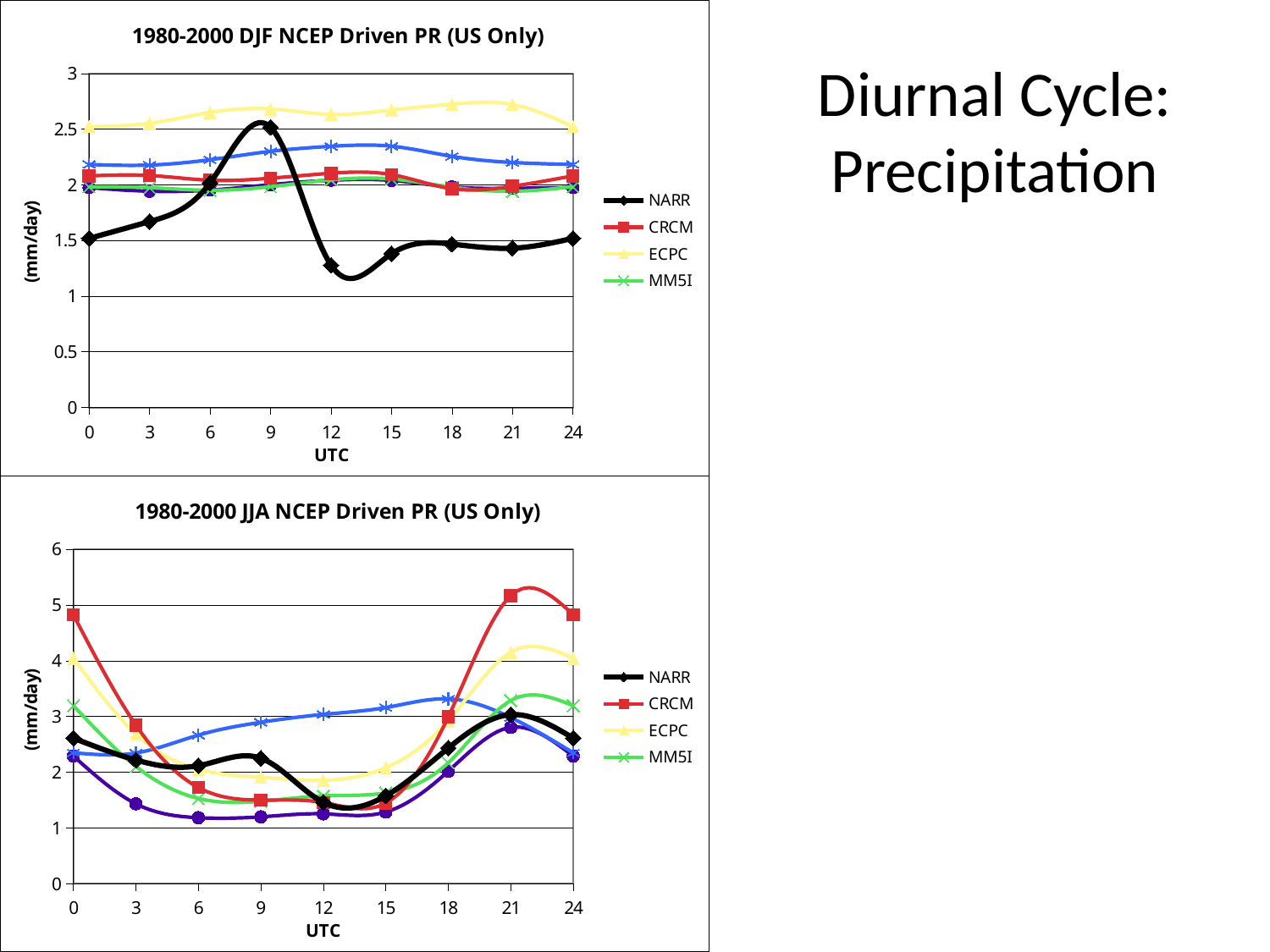
In the bottom chart, '1980-2000 JJA NCEP Driven PR (US Only)', is the CRCM value at 21 UTC greater or less than 5? greater How many UTC time points are plotted along the x axis of the top chart, '1980-2000 DJF NCEP Driven PR (US Only)'? 9 What kind of chart is the top chart, '1980-2000 DJF NCEP Driven PR (US Only)'? line chart How many series does the legend of the bottom chart, '1980-2000 JJA NCEP Driven PR (US Only)', list? 4 What is the y-axis label of the bottom chart, '1980-2000 JJA NCEP Driven PR (US Only)'? (mm/day) In the bottom chart, '1980-2000 JJA NCEP Driven PR (US Only)', which is larger at 0 UTC: CRCM or NARR? CRCM In the top chart, '1980-2000 DJF NCEP Driven PR (US Only)', which legend series has the highest values across the whole day? ECPC In the top chart, '1980-2000 DJF NCEP Driven PR (US Only)', which legend series has the lowest value at 0 UTC? NARR In the top chart, '1980-2000 DJF NCEP Driven PR (US Only)', is the NARR value at 9 UTC greater or less than 2? greater In the top chart, '1980-2000 DJF NCEP Driven PR (US Only)', is the NARR value at 12 UTC greater or less than 1.5? less In the bottom chart, '1980-2000 JJA NCEP Driven PR (US Only)', does the CRCM series rise or fall from 0 UTC to 6 UTC? fall